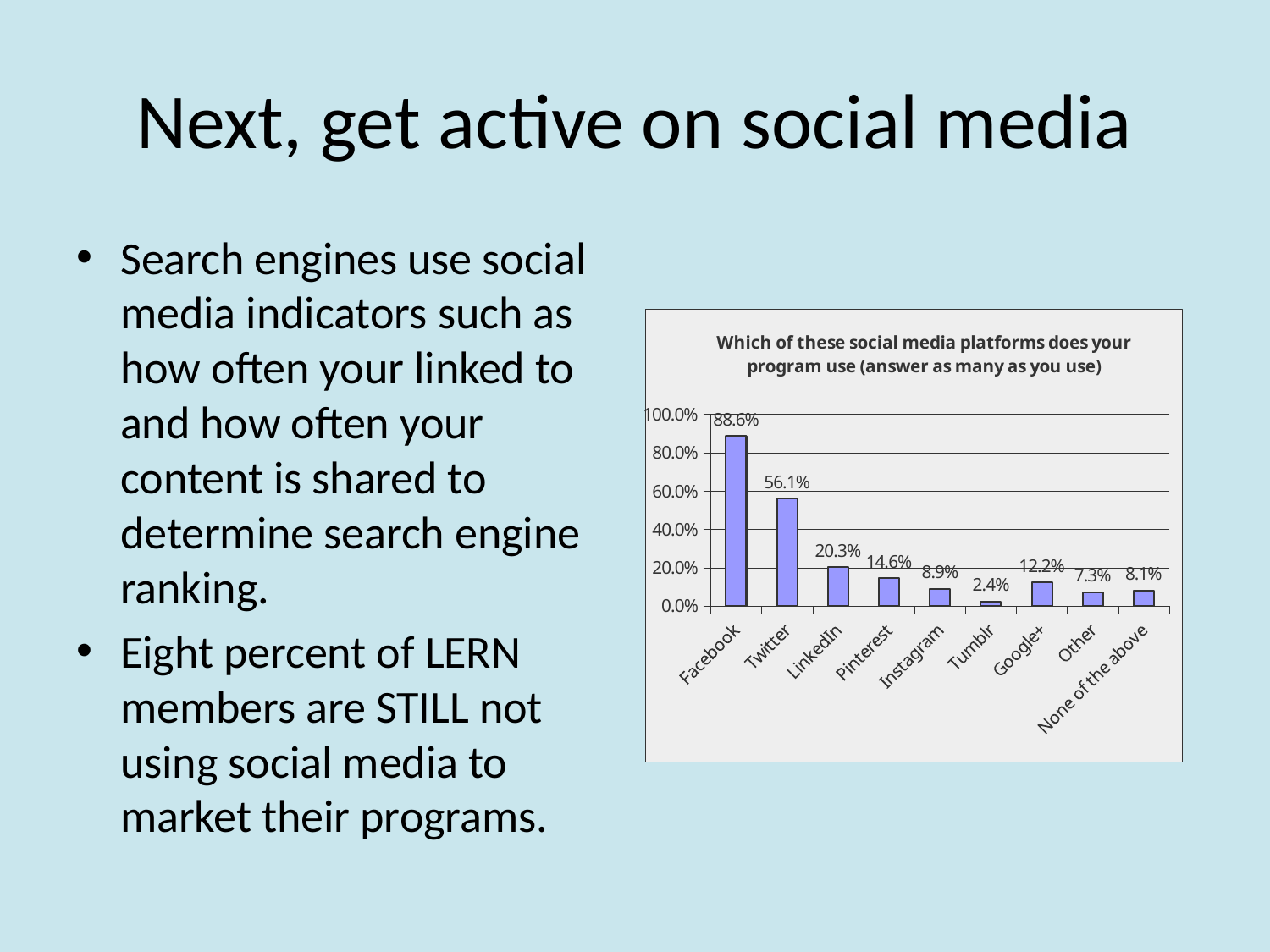
Is the value for Google+ greater or less than 20.0%? less What is the title of the chart? Which of these social media platforms does your program use (answer as many as you use) What is the difference between the values for Facebook and Twitter? 32.5% What percentage of programs use Facebook? 88.6% What is the value for 'None of the above'? 8.1% What type of chart is shown on the slide? bar chart What percentage is shown for Tumblr? 2.4% What is the value shown for Twitter? 56.1% How many categories are shown on the x axis of the chart? 9 Which is larger, the value for LinkedIn or the value for Pinterest? LinkedIn Which category has the lowest value in the chart? Tumblr Which social media platform has the highest value in the chart? Facebook